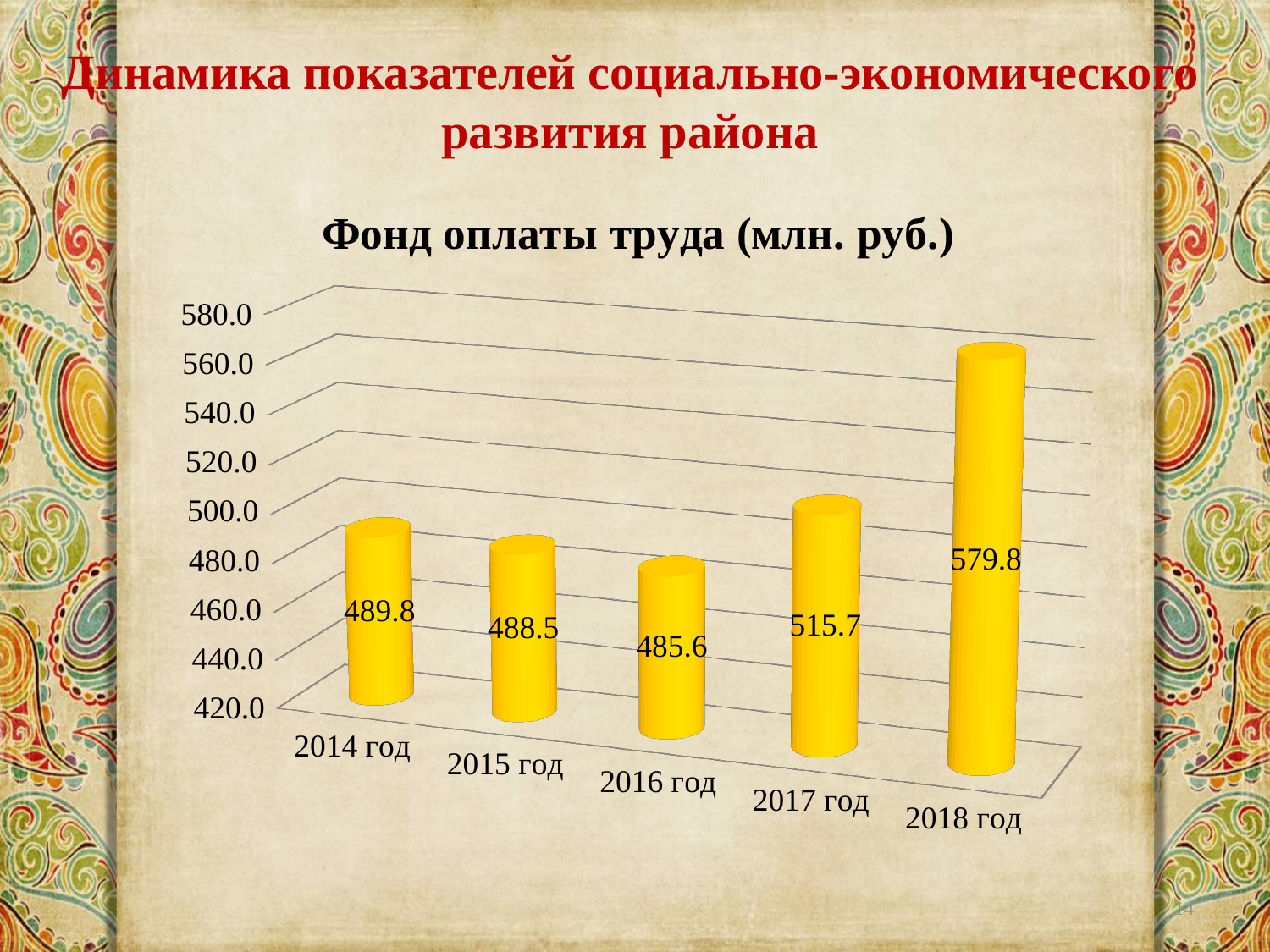
Which year has the highest value? 2018 год What kind of chart is this? bar chart What is the difference between the values for 2018 год and 2017 год? 64.1 What is the value for 2018 год? 579.8 What is the value for 2014 год? 489.8 Is the value for 2017 год greater or less than 500.0? greater Which is larger, the value for 2017 год or the value for 2015 год? 2017 год What is the value for 2016 год? 485.6 Which year has the lowest value? 2016 год How many years are shown on the chart? 5 What is the title of the chart? Фонд оплаты труда (млн. руб.) What is the difference between the values for 2014 год and 2016 год? 4.2